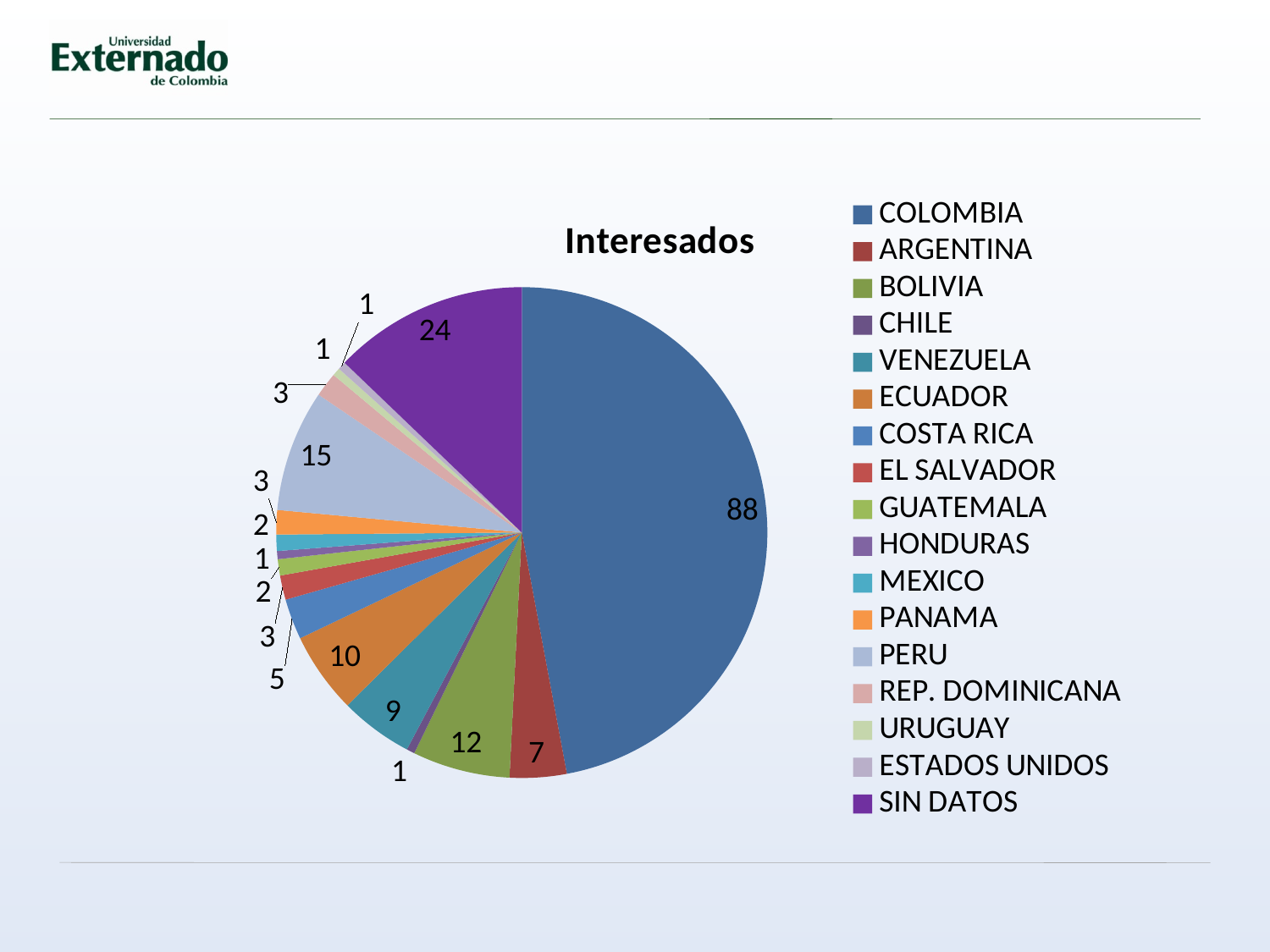
What is the title of the chart? Interesados What is the value for COLOMBIA in the pie chart? 88 What is the value for SIN DATOS in the pie chart? 24 Which category has the largest slice of the pie? COLOMBIA What is the difference between the values for COLOMBIA and SIN DATOS? 64 What is the value for PERU in the pie chart? 15 Which is larger, the value for VENEZUELA or the value for ARGENTINA? VENEZUELA What type of chart is shown on the slide? pie chart What is the value for ECUADOR in the pie chart? 10 What is the value for BOLIVIA in the pie chart? 12 What is the difference between the values for PERU and COSTA RICA? 10 How many categories does the legend list? 17